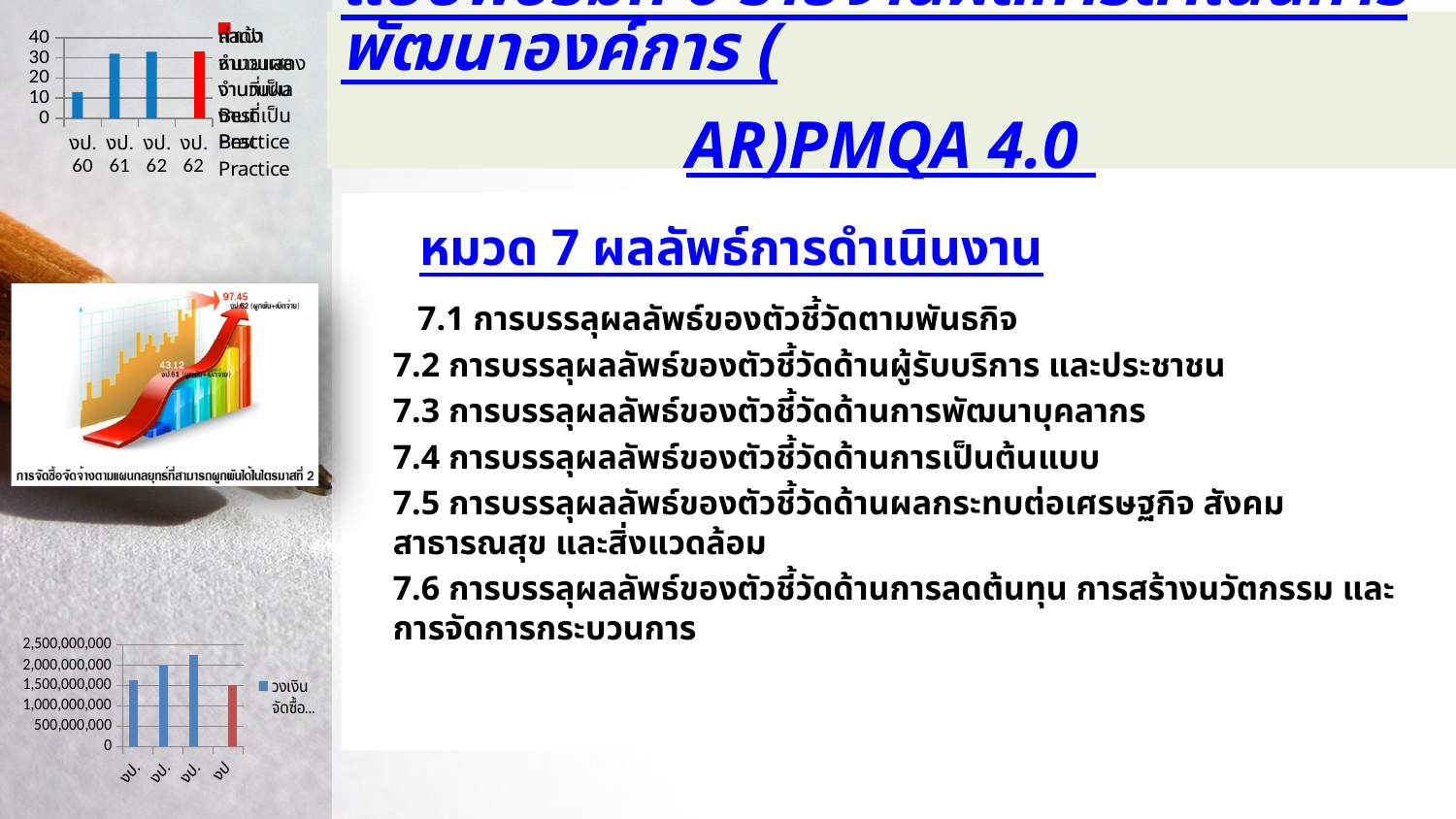
In the middle-left chart, which is larger, the value for งป.62 or the value for งป.61? งป.62 In the middle-left chart titled การจัดซื้อจัดจ้างตามแผนกลยุทธ์ที่สามารถผูกพันได้ในไตรมาสที่ 2, what value is labelled for งป.62? 97.45 In the top-left chart, which is larger, the value for งป. 60 or the value for งป. 61? งป. 61 In the middle-left chart titled การจัดซื้อจัดจ้างตามแผนกลยุทธ์ที่สามารถผูกพันได้ในไตรมาสที่ 2, what value is labelled for งป.61? 43.12 What kind of chart is the bottom-left chart on the slide? bar chart In the top-left chart, is the value for งป. 60 greater or less than 20? less What kind of chart is the top-left chart on the slide? bar chart In the top-left chart, is the value for งป. 61 greater or less than 20? greater How many bars are plotted in the bottom-left chart? 4 In the bottom-left chart, is the value of the third bar from the left greater or less than 2,000,000,000? greater How many categories are shown on the x axis of the top-left chart? 4 In the top-left chart, do the values rise or fall from งป. 60 to งป. 62? rise